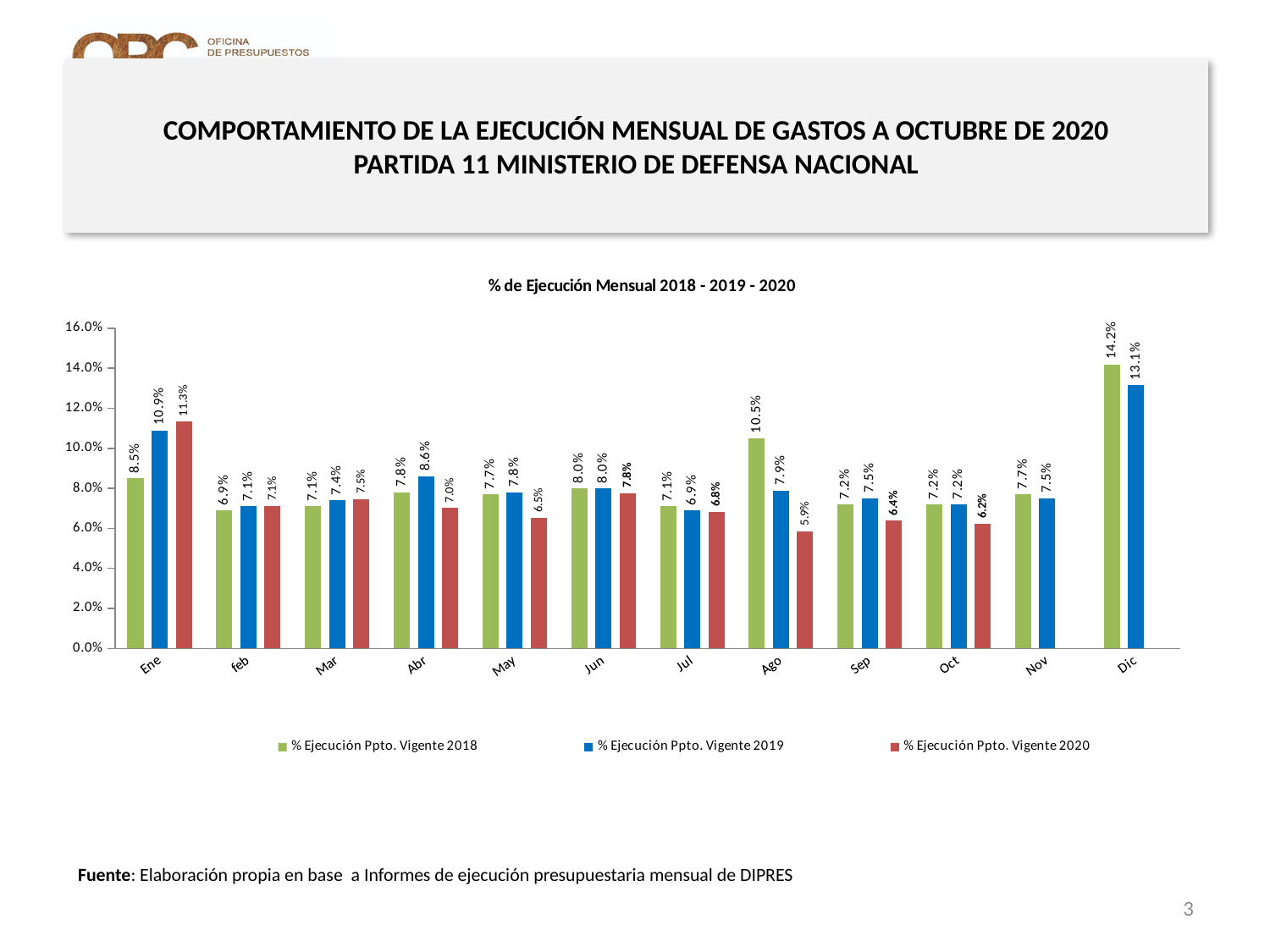
What is the value for % Ejecución Ppto. Vigente 2019 in Abr? 8.6% In which month is the % Ejecución Ppto. Vigente 2020 value highest? Ene What is the difference between the 2020 and 2018 values in Ene? 2.8 percentage points How many series does the legend list? 3 Is the value for % Ejecución Ppto. Vigente 2019 in Dic greater or less than 12.0%? greater In which month is the % Ejecución Ppto. Vigente 2020 value lowest? Ago What is the value for % Ejecución Ppto. Vigente 2018 in Dic? 14.2% What is the title of the chart? % de Ejecución Mensual 2018 - 2019 - 2020 How many months are shown on the x axis? 12 What kind of chart is shown on the slide? bar chart What is the value for % Ejecución Ppto. Vigente 2020 in Ene? 11.3% In Ago, which series has the larger value: % Ejecución Ppto. Vigente 2018 or % Ejecución Ppto. Vigente 2019? % Ejecución Ppto. Vigente 2018